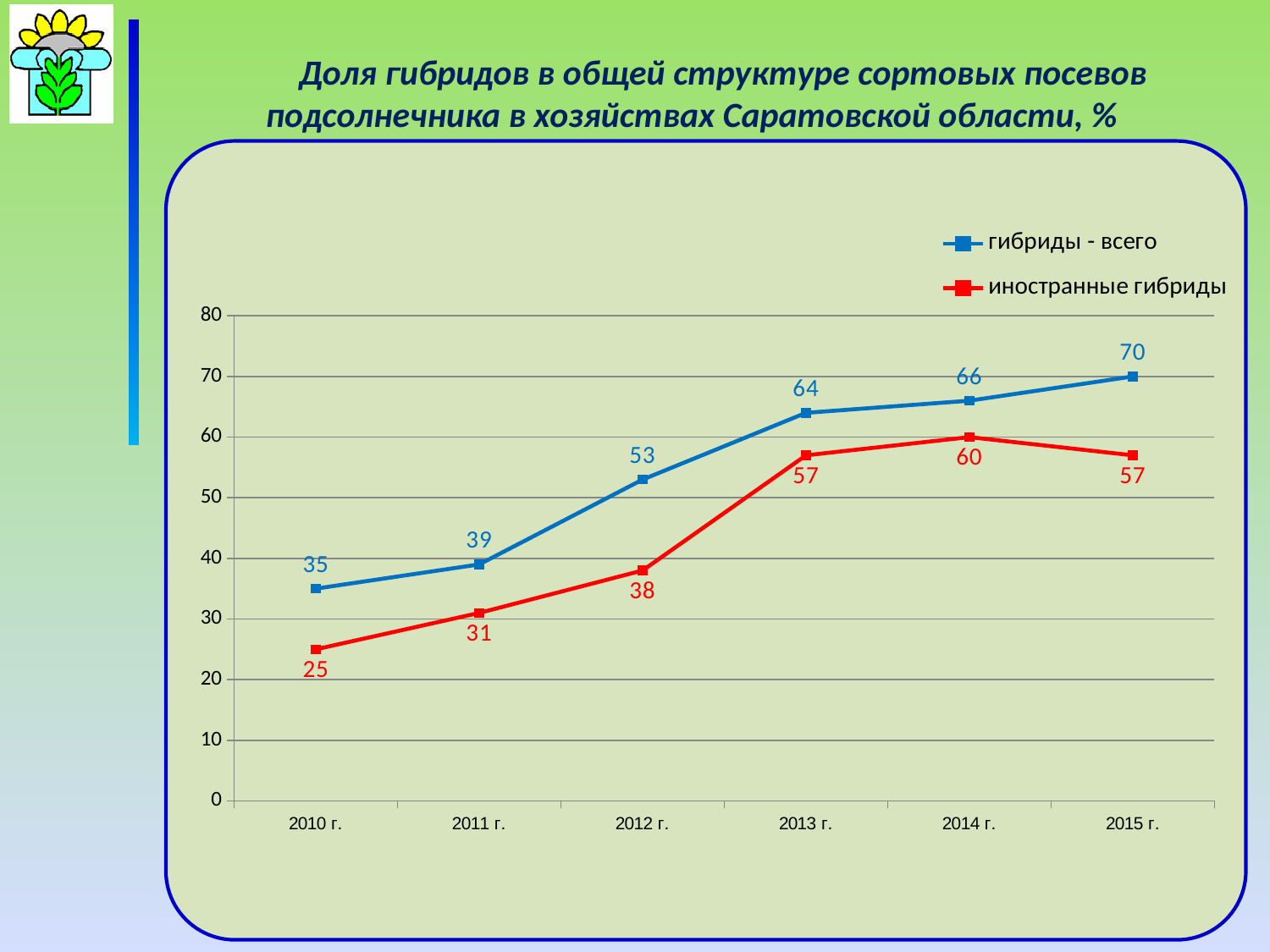
What is the value for "иностранные гибриды" in 2011 г.? 31 Which is larger: "иностранные гибриды" in 2013 г. or in 2015 г.? They are equal (57) How many years are shown on the x axis? 6 Is the value for "гибриды - всего" in 2011 г. greater or less than 40? less What is the value for "гибриды - всего" in 2013 г.? 64 What kind of chart is shown on the slide? Line chart In which year is the value for "гибриды - всего" highest? 2015 г. What is the difference between "гибриды - всего" and "иностранные гибриды" in 2012 г.? 15 How many series does the legend list? 2 In which year is the value for "иностранные гибриды" lowest? 2010 г. What is the value for "иностранные гибриды" in 2014 г.? 60 Does the value for "гибриды - всего" rise or fall from 2010 г. to 2015 г.? Rises